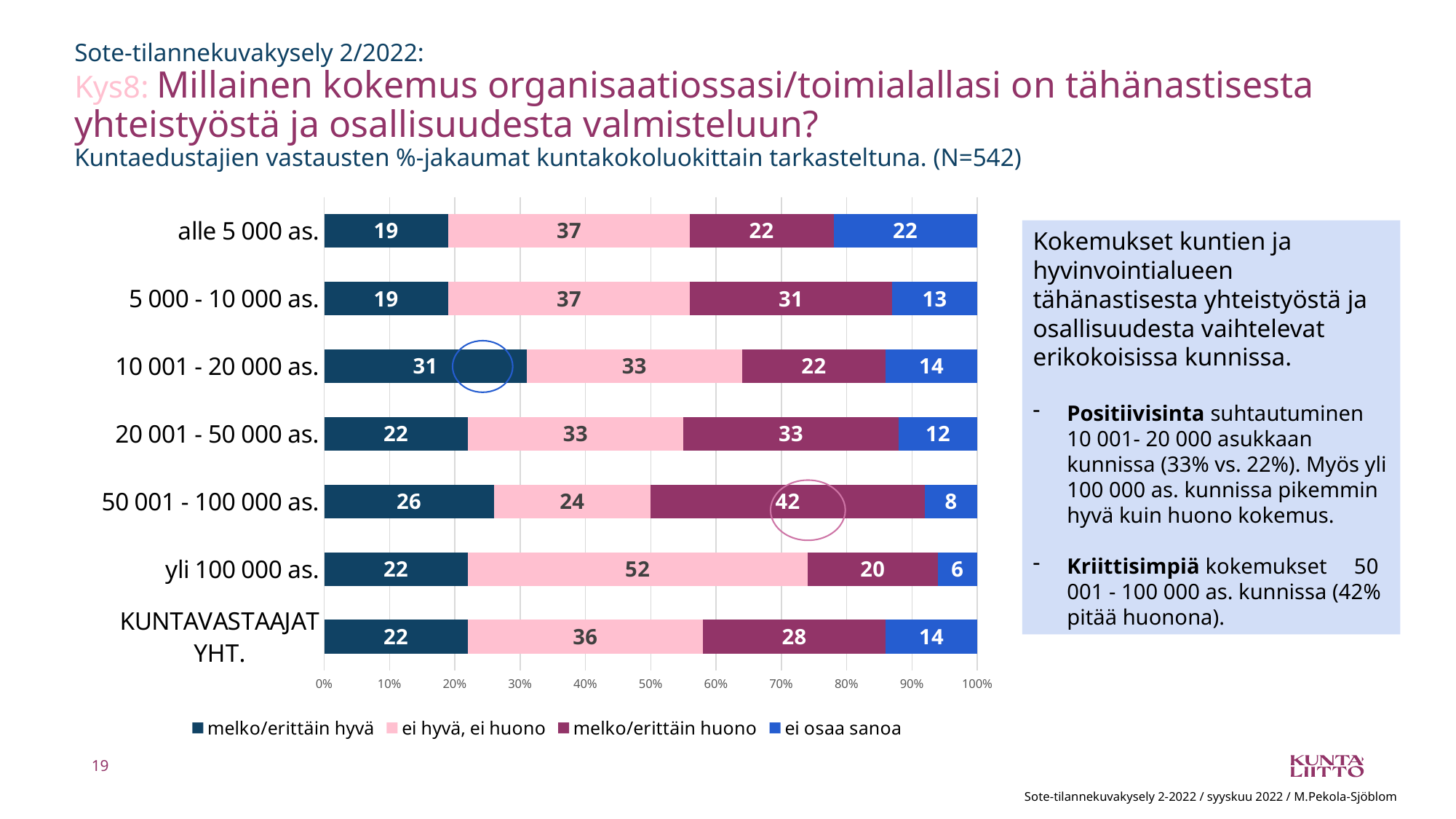
What is the value for "melko/erittäin huono" in the "50 001 - 100 000 as." category? 42 How many categories are shown on the y axis of the chart? 7 What is the difference between the "melko/erittäin huono" values for "50 001 - 100 000 as." and "yli 100 000 as."? 22 Which category has the highest value for "melko/erittäin hyvä"? 10 001 - 20 000 as. What is the value for "ei hyvä, ei huono" in the "yli 100 000 as." category? 52 Which legend entry is shown in bright blue? ei osaa sanoa What is the total of the stacked bar for "alle 5 000 as."? 100 How many series does the legend list? 4 What kind of chart is shown on the slide? Stacked bar chart Which category has the larger "ei osaa sanoa" value: "alle 5 000 as." or "5 000 - 10 000 as."? alle 5 000 as. Which category has the lowest value for "ei osaa sanoa"? yli 100 000 as. What is the value for "melko/erittäin hyvä" in the "KUNTAVASTAAJAT YHT." category? 22